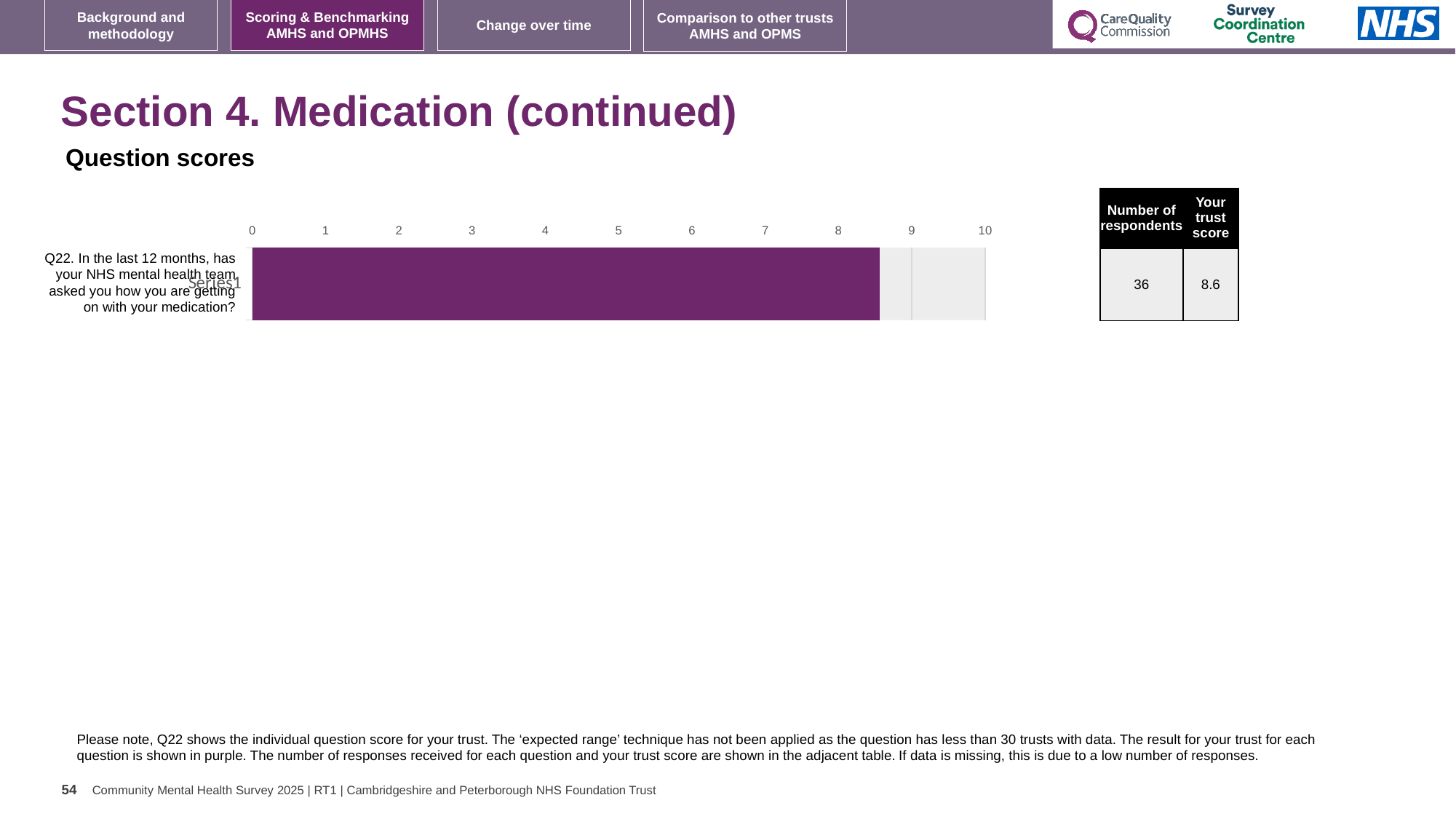
What colour is the bar for Q22? purple How many questions (bars) are plotted in the chart? 1 What is the maximum value shown on the chart's horizontal axis? 10 What kind of chart is shown on the slide? bar chart Is the value for Q22 greater or less than 9? less Is the value for Q22 greater or less than 5? greater Is the value for Q22 greater or less than 8? greater According to the adjacent table, what is the trust score for Q22? 8.6 According to the adjacent table, how many respondents answered Q22? 36